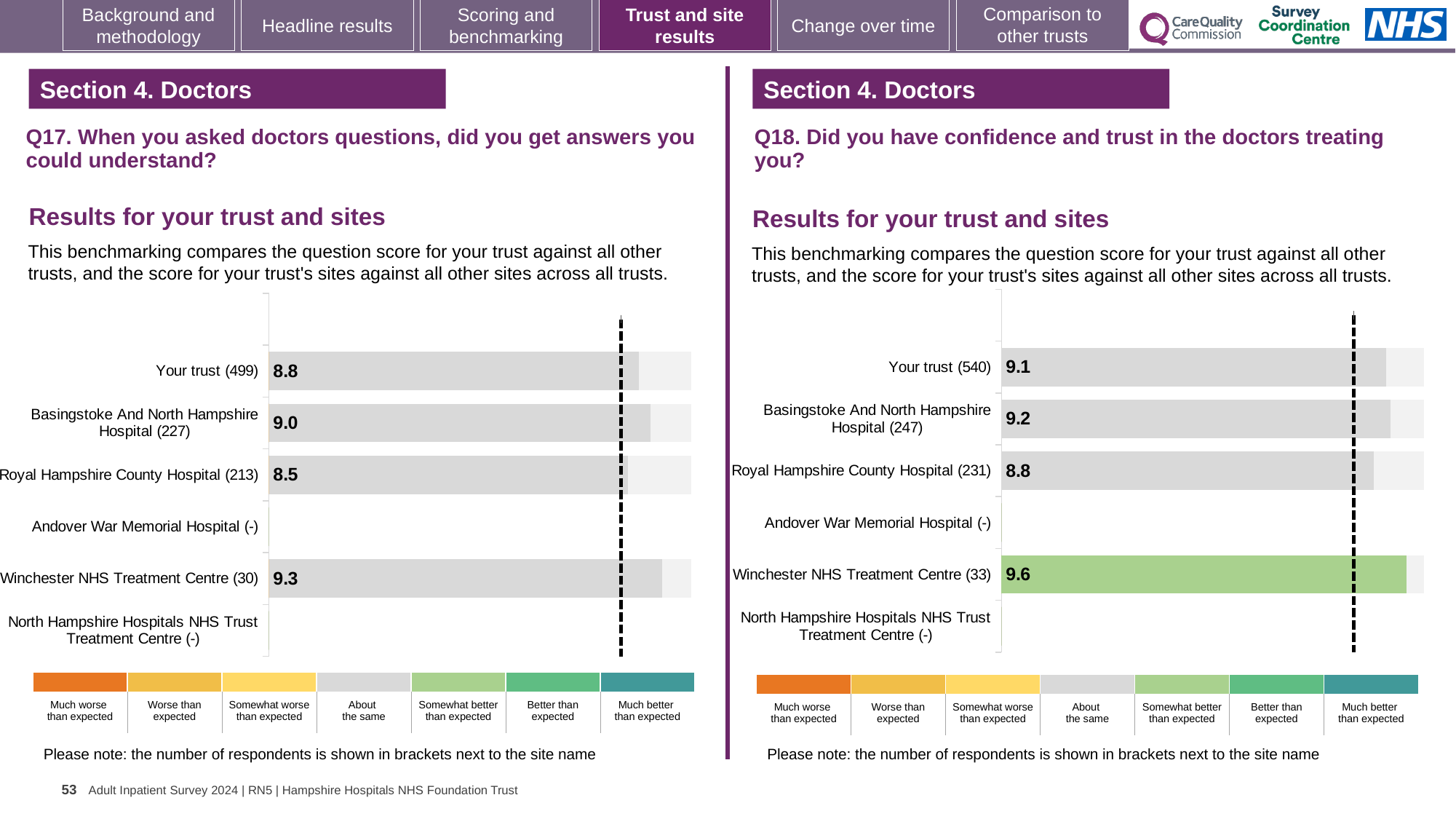
In the Q18 chart on the right, which site's bar is coloured green, indicating 'Somewhat better than expected'? Winchester NHS Treatment Centre (33) In the Q17 chart on the left, what is the score for Royal Hampshire County Hospital (213)? 8.5 How many site rows (categories) are listed in the Q17 chart on the left? 6 In the Q17 chart on the left, what is the score for Your trust (499)? 8.8 In the Q18 chart on the right, what is the difference between the scores for Basingstoke And North Hampshire Hospital (247) and Your trust (540)? 0.1 In the Q18 chart on the right, what is the score for Winchester NHS Treatment Centre (33)? 9.6 In the Q17 chart on the left, what is the difference between the scores for Winchester NHS Treatment Centre (30) and Royal Hampshire County Hospital (213)? 0.8 In the Q17 chart on the left, which site with a score shown has the lowest score? Royal Hampshire County Hospital (213) In the Q18 chart on the right, which is higher: the score for Basingstoke And North Hampshire Hospital (247) or Royal Hampshire County Hospital (231)? Basingstoke And North Hampshire Hospital (247) In the Q18 chart on the right, what is the score for Your trust (540)? 9.1 In the Q17 chart on the left, which site has the highest score? Winchester NHS Treatment Centre (30) What kind of chart is used in the Q18 chart on the right? Bar chart